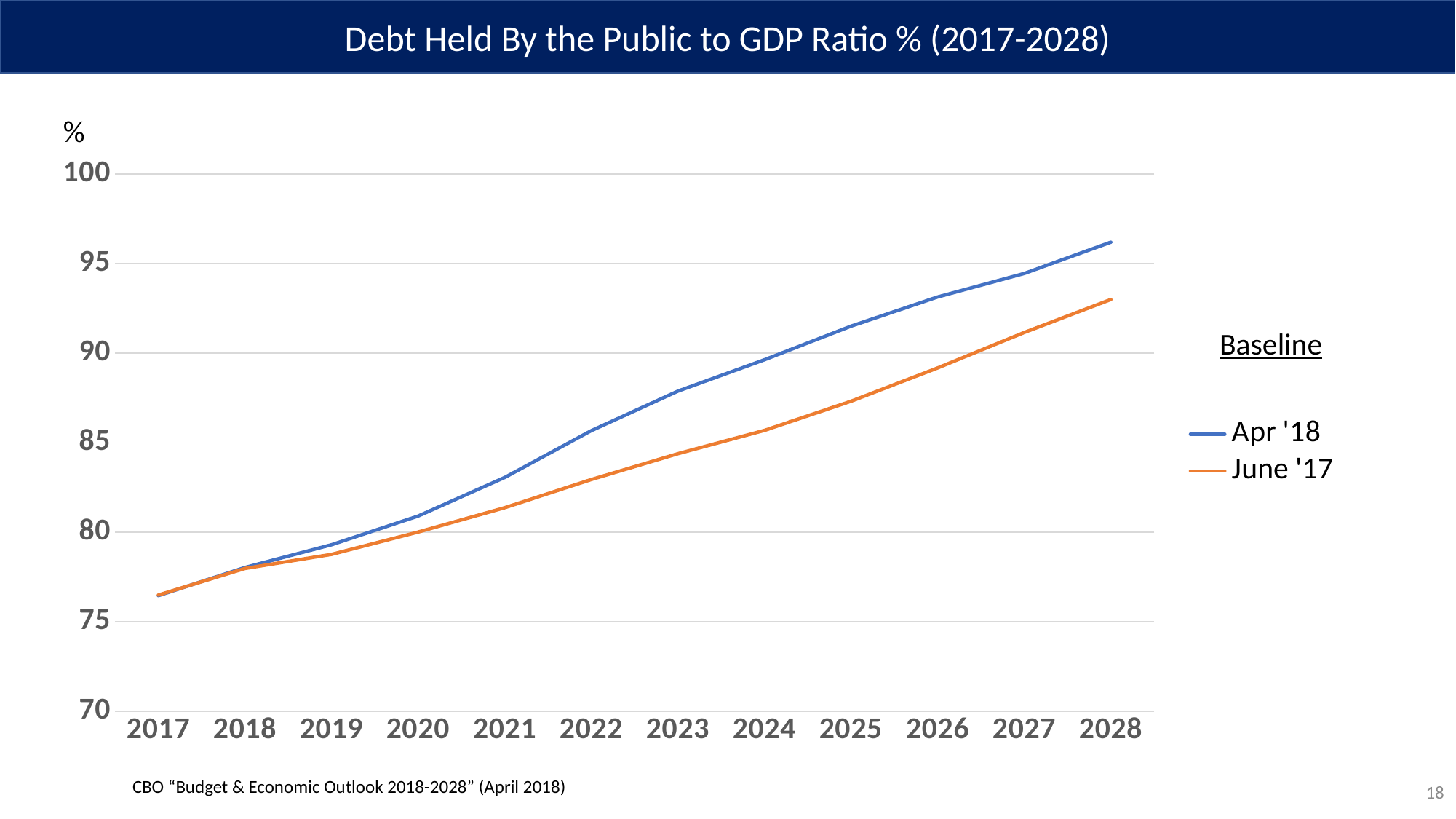
How many series does the legend list? 2 Is the value for Apr '18 in 2028 greater or less than 95? greater In 2028, which series has the larger value, Apr '18 or June '17? Apr '18 How many years are plotted along the x axis? 12 In which year is the June '17 series at its lowest? 2017 Do the values for the Apr '18 series rise or fall from 2017 to 2028? Rise Is the value for June '17 in 2028 greater or less than 95? less In which year is the Apr '18 series at its highest? 2028 What kind of chart is shown on the slide? Line chart What is the title of the chart? Debt Held By the Public to GDP Ratio % (2017-2028) Is the value for Apr '18 in 2023 greater or less than 85? greater